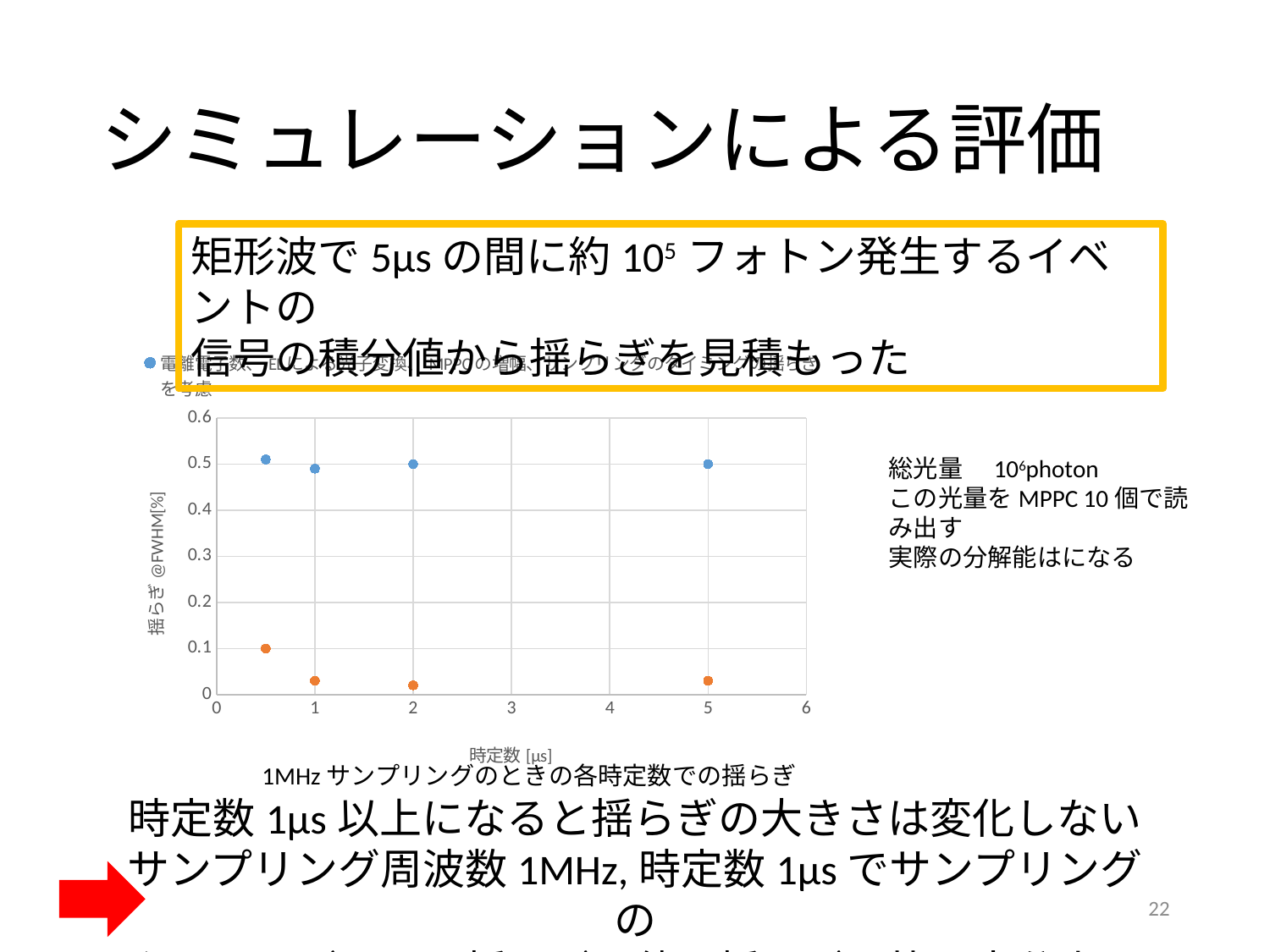
How many series are plotted in the chart? 2 At which 時定数 value does the orange series reach its highest point? 0.5 What kind of chart is shown on the slide? scatter chart Is the blue series value at 時定数 5 μs greater or less than 0.3? greater Do the orange series values rise or fall from 時定数 0.5 μs to 2 μs? fall How many data points does the orange series have? 4 How many data points does the blue series have? 4 Is the blue series value at 時定数 0.5 μs greater or less than 0.4? greater Is the orange series value at 時定数 0.5 μs greater or less than 0.2? less At 時定数 1 μs, which series has the larger value, blue or orange? blue What is the title of the vertical axis of the chart? 揺らぎ @FWHM[%]